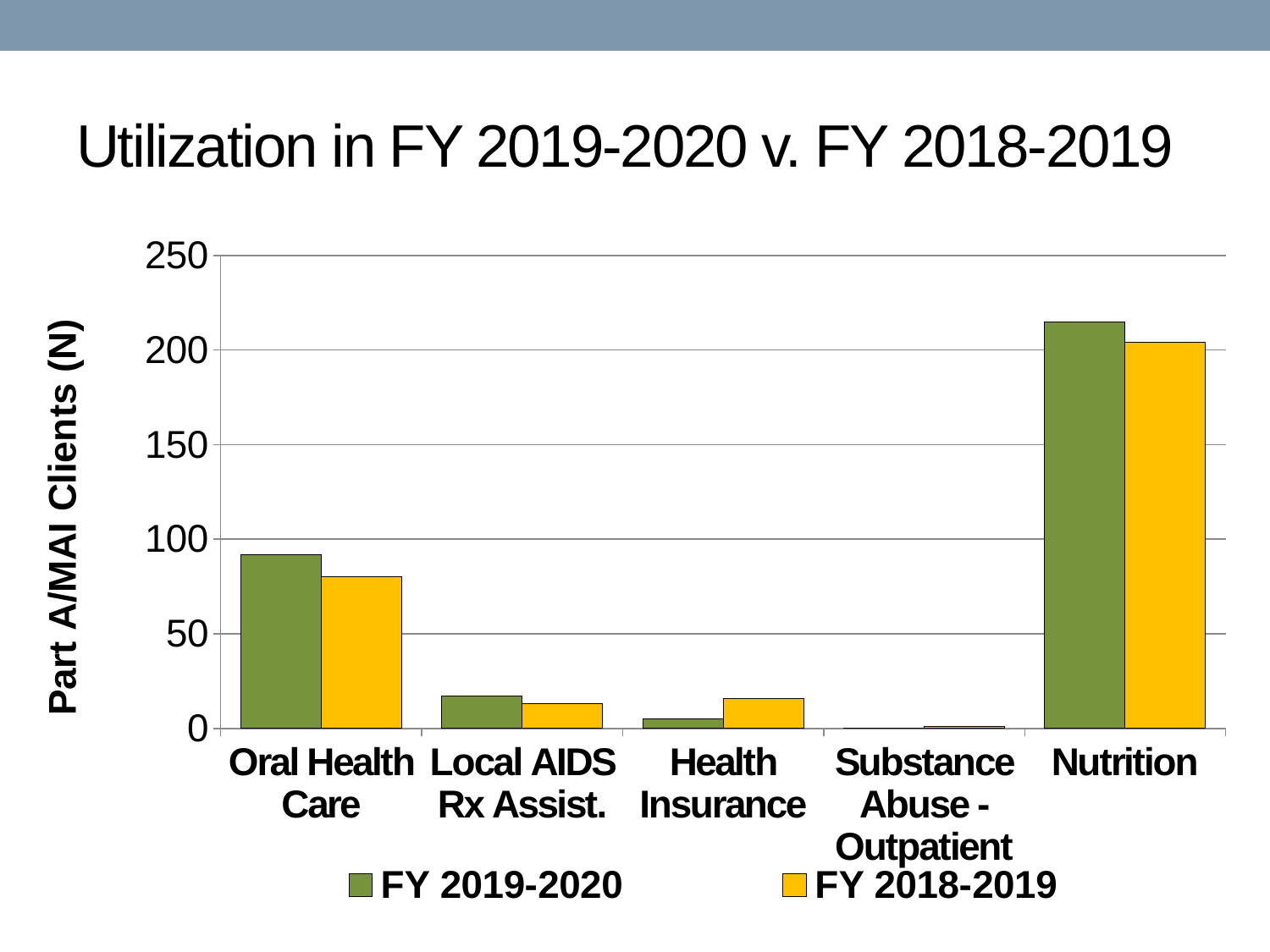
Is the FY 2019-2020 value for Nutrition greater or less than 200? greater For Health Insurance, which series has the larger value, FY 2019-2020 or FY 2018-2019? FY 2018-2019 Which category has the highest value for FY 2019-2020? Nutrition What is the label on the y axis? Part A/MAI Clients (N) How many series does the legend list? 2 Is the FY 2019-2020 value for Local AIDS Rx Assist. greater or less than 50? less Is the FY 2018-2019 value for Oral Health Care greater or less than 50? greater What kind of chart is shown on the slide? bar chart Which category has the highest value for FY 2018-2019? Nutrition How many service categories are shown on the x axis? 5 Which category has the lowest value for FY 2019-2020? Substance Abuse - Outpatient